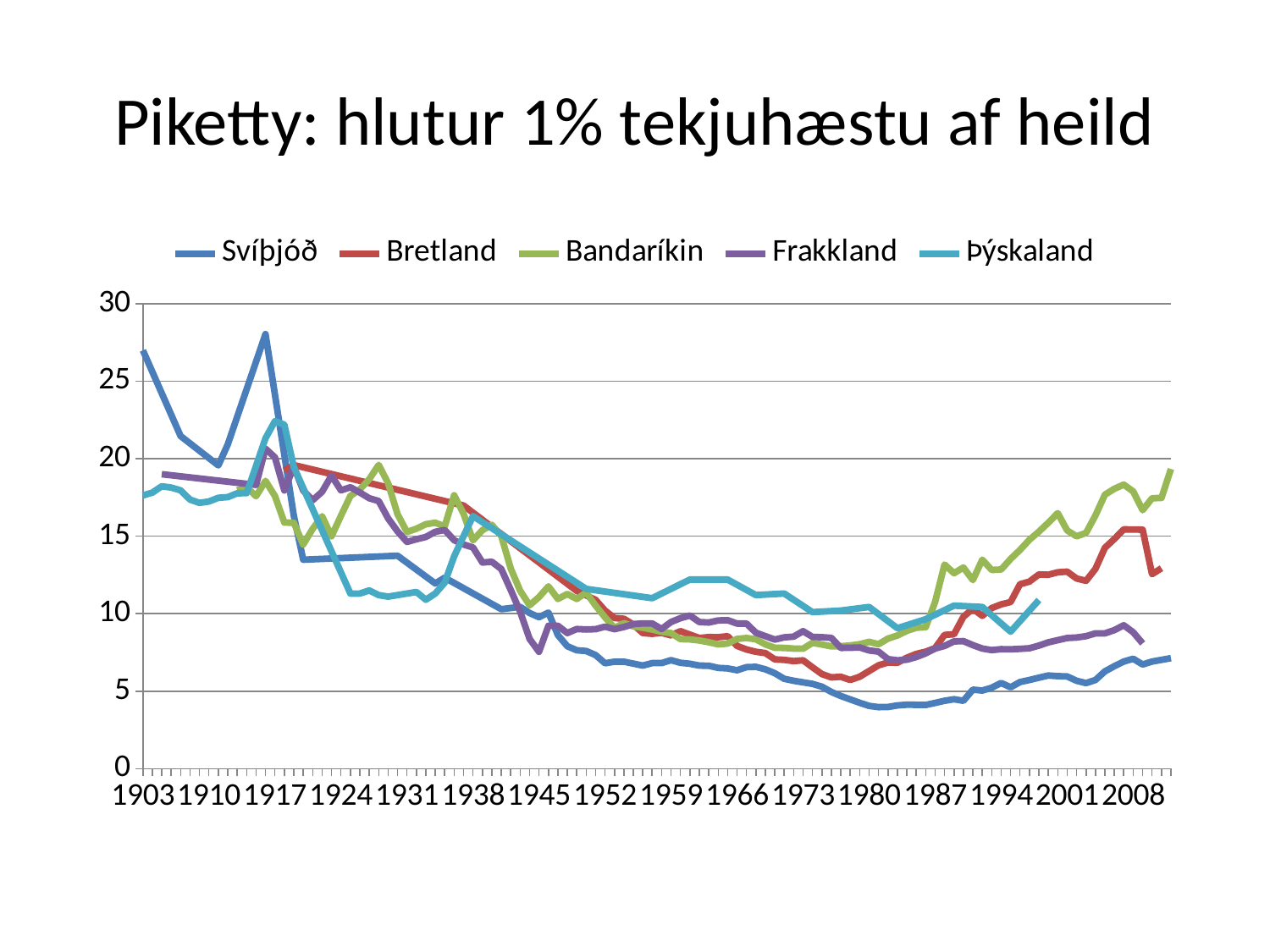
How many series does the legend list? 5 Which series has the lowest value around 1980? Svíþjóð Is the value for Svíþjóð in 1903 greater or less than 25? greater In 2008, which is higher: Bandaríkin or Svíþjóð? Bandaríkin Which series has the highest value at the right end of the chart (around 2008)? Bandaríkin Is the value for Bretland in 1980 greater or less than 10? less Does the Svíþjóð line rise or fall between 1903 and 1980? fall Is the value for Svíþjóð in 1980 greater or less than 5? less What kind of chart is shown on the slide? line chart What is the title of the chart? Piketty: hlutur 1% tekjuhæstu af heild Which countries are listed in the legend? Svíþjóð, Bretland, Bandaríkin, Frakkland, Þýskaland